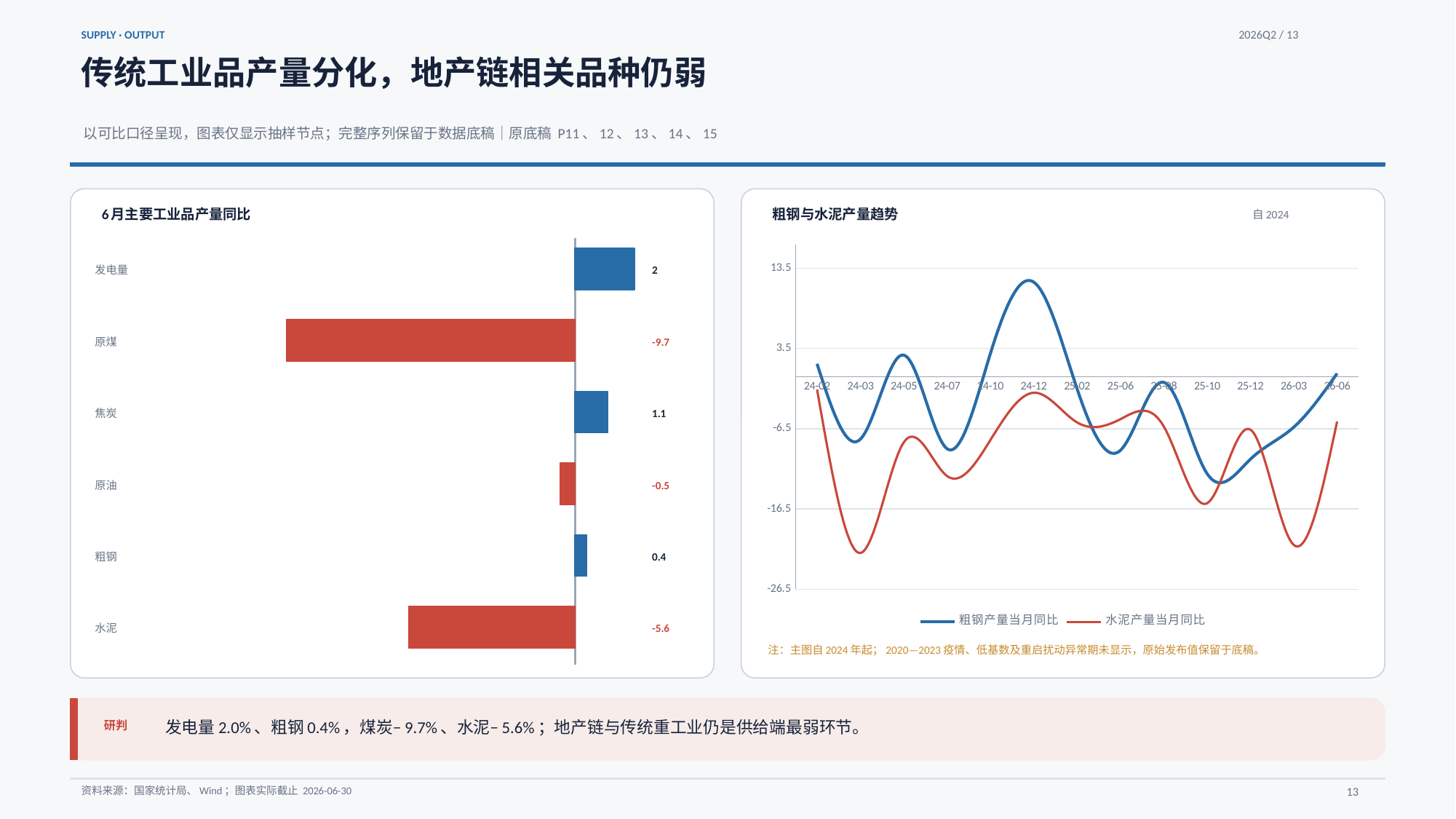
In the chart titled 6月主要工业品产量同比, what is the value for 水泥? -5.6 In the chart titled 粗钢与水泥产量趋势, how many series does the legend list? 2 In the chart titled 6月主要工业品产量同比, how many categories are shown? 6 In the chart titled 6月主要工业品产量同比, which category has the lowest value? 原煤 In the chart titled 粗钢与水泥产量趋势, is the value of 水泥产量当月同比 at 24-03 greater or less than -16.5? less In the chart titled 6月主要工业品产量同比, what is the value for 焦炭? 1.1 In the chart titled 6月主要工业品产量同比, which category has the highest value? 发电量 In the chart titled 粗钢与水泥产量趋势, is the value of 粗钢产量当月同比 at 24-12 greater or less than 3.5? greater In the chart titled 6月主要工业品产量同比, what is the value for 原煤? -9.7 In the chart titled 6月主要工业品产量同比, what is the difference between the values for 发电量 and 粗钢? 1.6 In the chart titled 6月主要工业品产量同比, which is larger, the value for 焦炭 or the value for 粗钢? 焦炭 What kind of chart is the chart titled 6月主要工业品产量同比? bar chart